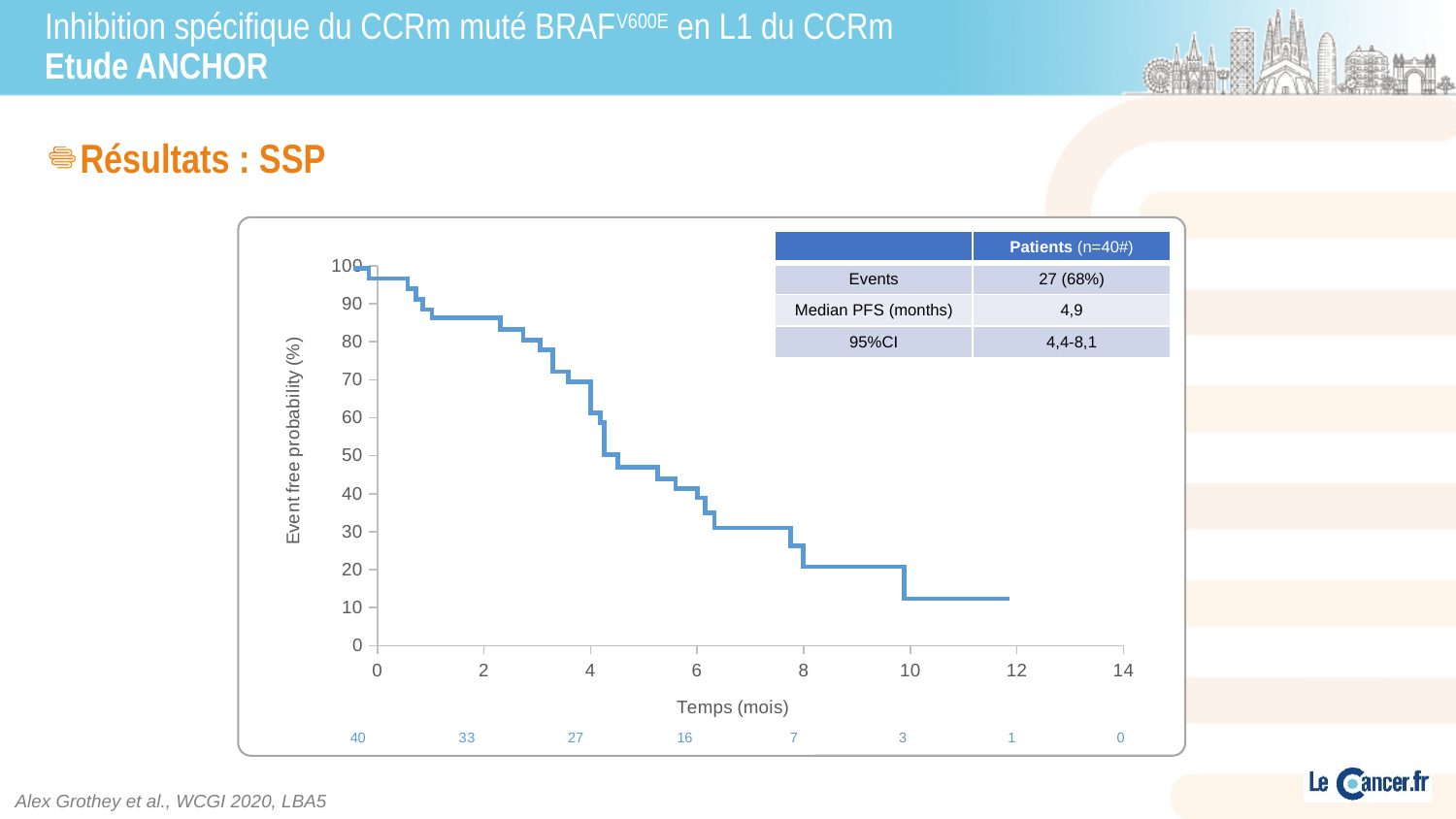
Is the event free probability at 10 months greater or less than 20? less What is the label of the y axis of the chart? Event free probability (%) How many tick marks are labelled on the x axis of the chart? 8 What kind of chart is shown on the slide? line chart Is the event free probability at 5 months greater or less than 50? less According to the number-at-risk row below the x axis, how many patients are at risk at 6 months? 16 Does the event free probability rise or fall as time increases along the x axis? fall What is the label of the x axis of the chart? Temps (mois) Is the event free probability at 3 months greater or less than 70? greater According to the number-at-risk row below the x axis, how many patients are at risk at 0 months? 40 What is the difference between the number of patients at risk at 0 months and at 2 months? 7